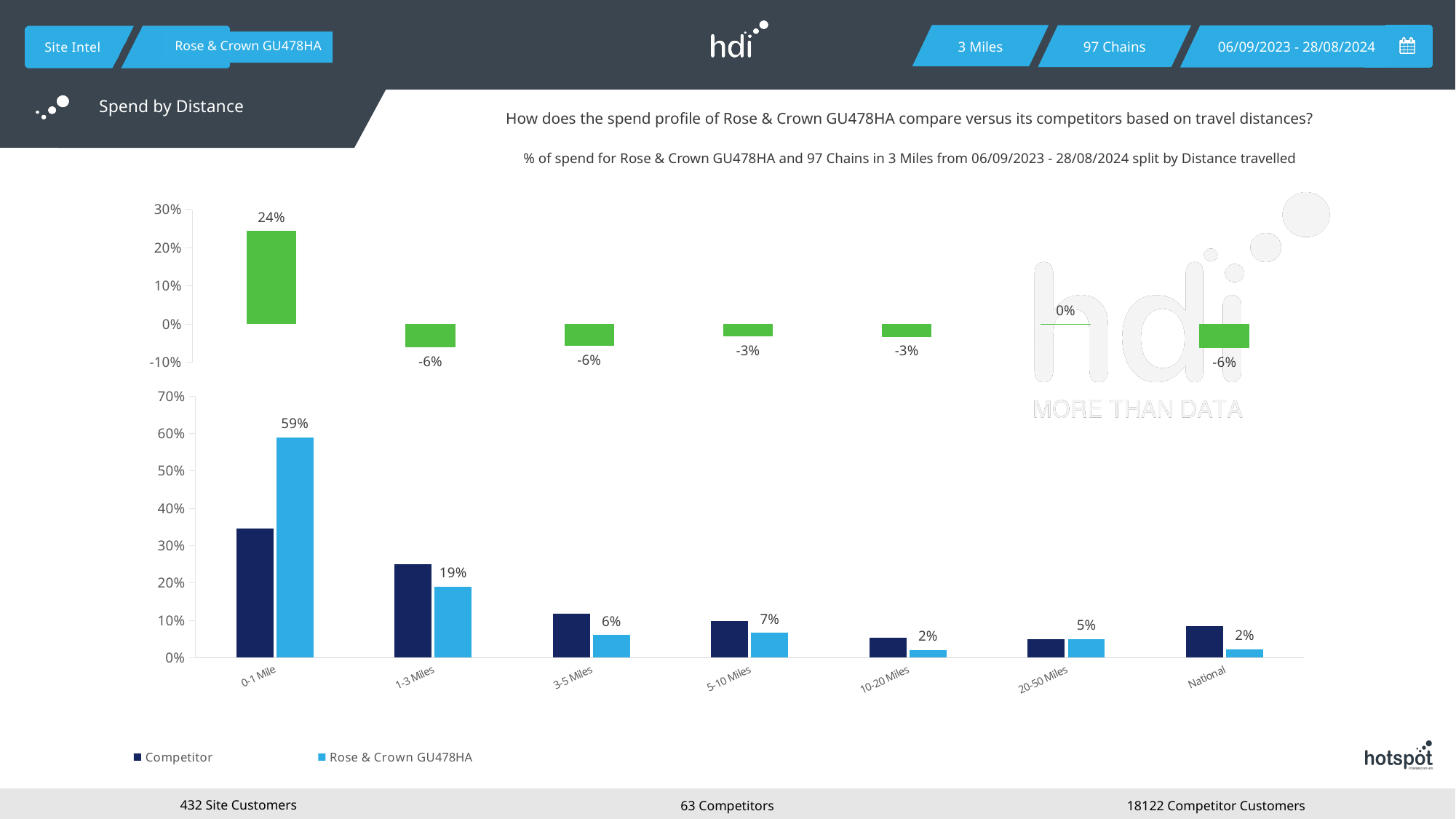
What kind of chart is the bottom chart on the slide? bar chart How many distance categories are shown on the x axis of the bottom chart? 7 In the bottom chart, what is the value for Rose & Crown GU478HA at 1-3 Miles? 19% In the bottom chart, at 3-5 Miles, which is larger: the Competitor value or the Rose & Crown GU478HA value? Competitor In the bottom chart, what is the difference between the Rose & Crown GU478HA values at 0-1 Mile and 1-3 Miles? 40 percentage points In the bottom chart, which distance band has the highest value for Rose & Crown GU478HA? 0-1 Mile In the top chart, what is the value of the first (leftmost) green bar? 24% In the bottom chart, is the Competitor value at 0-1 Mile greater or less than 30%? greater In the bottom chart, what is the value for Rose & Crown GU478HA at 0-1 Mile? 59% In the bottom chart, how many series does the legend list? 2 In the bottom chart, is the Competitor value at 1-3 Miles greater or less than 20%? greater In the bottom chart, do the Rose & Crown GU478HA values rise or fall from 0-1 Mile to 10-20 Miles? fall